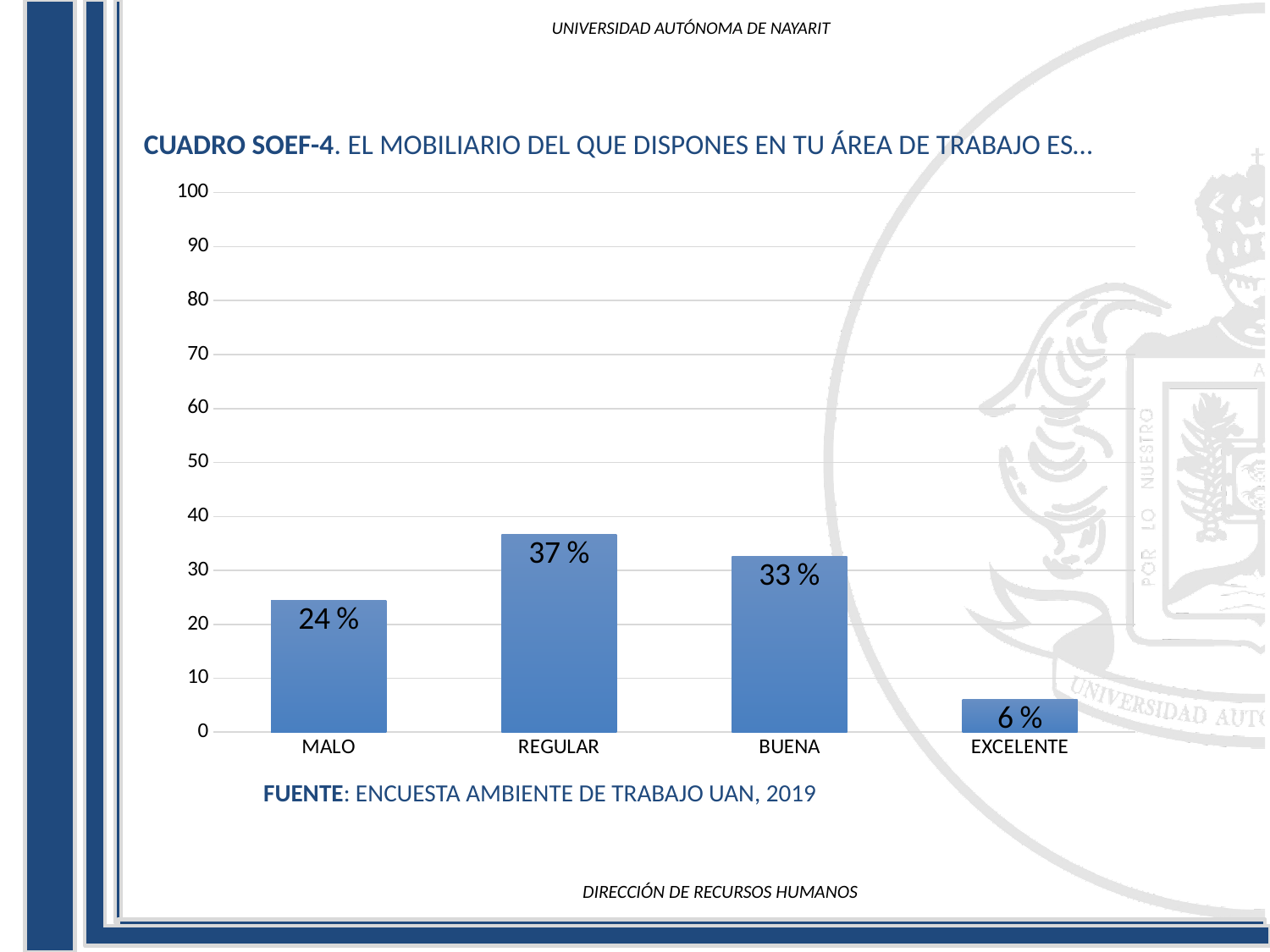
Is the value for BUENA greater or less than 40? less Which category has the lowest value? EXCELENTE What is the difference between the values for REGULAR and BUENA? 4 % What is the value for EXCELENTE? 6 % What is the difference between the values for MALO and EXCELENTE? 18 % What kind of chart is shown on the slide? bar chart What is the value for REGULAR? 37 % What source is cited below the chart? ENCUESTA AMBIENTE DE TRABAJO UAN, 2019 Which is larger, the value for MALO or the value for BUENA? BUENA What is the value for MALO? 24 % Which category has the highest value? REGULAR How many categories are shown on the x axis? 4